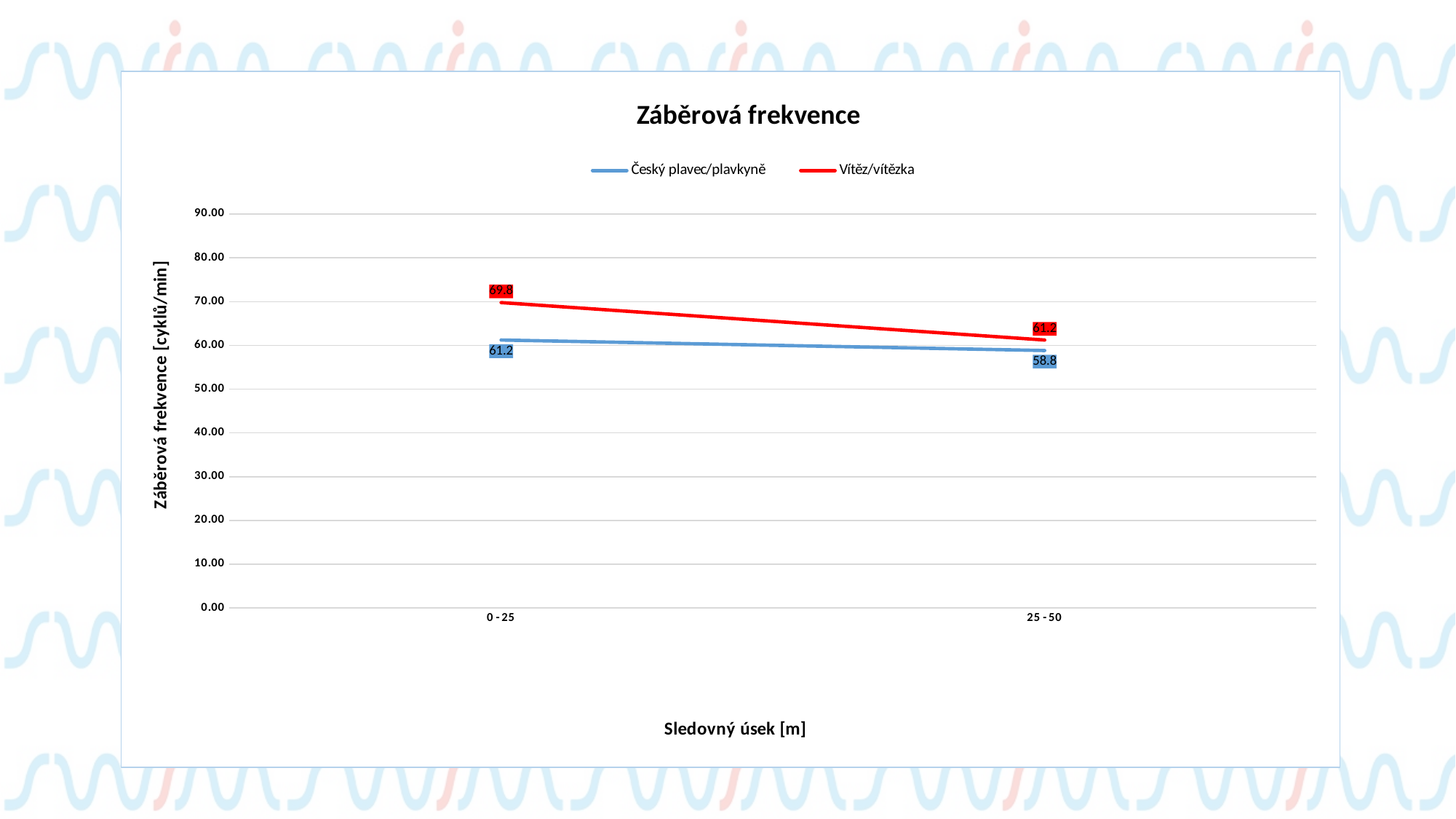
Do the values for Vítěz/vítězka rise or fall from 0 - 25 to 25 - 50? fall How many categories are shown on the x axis? 2 What is the value for Český plavec/plavkyně at 0 - 25? 61.2 What is the value for Vítěz/vítězka at 0 - 25? 69.8 What is the value for Vítěz/vítězka at 25 - 50? 61.2 How many series does the legend list? 2 Which series has the higher value at 25 - 50, Český plavec/plavkyně or Vítěz/vítězka? Vítěz/vítězka What kind of chart is shown? line chart What is the value for Český plavec/plavkyně at 25 - 50? 58.8 What is the difference between the Vítěz/vítězka values at 0 - 25 and 25 - 50? 8.6 Is the value for Vítěz/vítězka at 0 - 25 greater or less than 60.00? greater What is the difference between Vítěz/vítězka and Český plavec/plavkyně at 0 - 25? 8.6